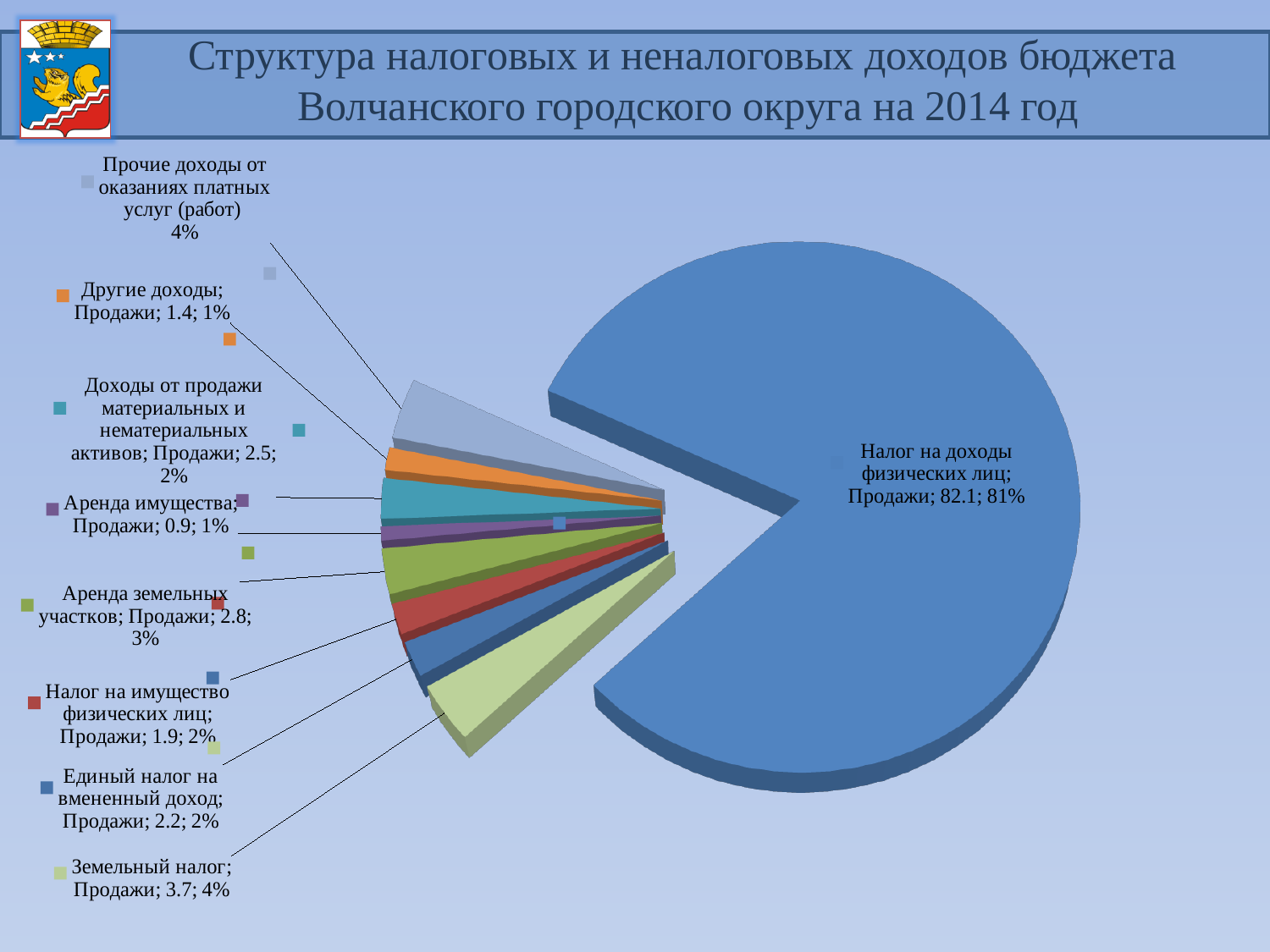
What value is printed for Аренда земельных участков? 2.8 What is the title of the chart on the slide? Структура налоговых и неналоговых доходов бюджета Волчанского городского округа на 2014 год What value is printed for Земельный налог? 3.7 Which category has the smallest printed value? Аренда имущества What kind of chart is shown on the slide? pie chart How many slices does the pie chart have? 9 What share of the pie does Аренда земельных участков represent? 3% Which category has the largest slice of the pie? Налог на доходы физических лиц What share of the pie does Налог на доходы физических лиц represent? 81% What is the difference between the values for Земельный налог and Единый налог на вмененный доход? 1.5 Which is larger, the value for Доходы от продажи материальных и нематериальных активов or the value for Налог на имущество физических лиц? Доходы от продажи материальных и нематериальных активов What value is printed for Налог на доходы физических лиц? 82.1